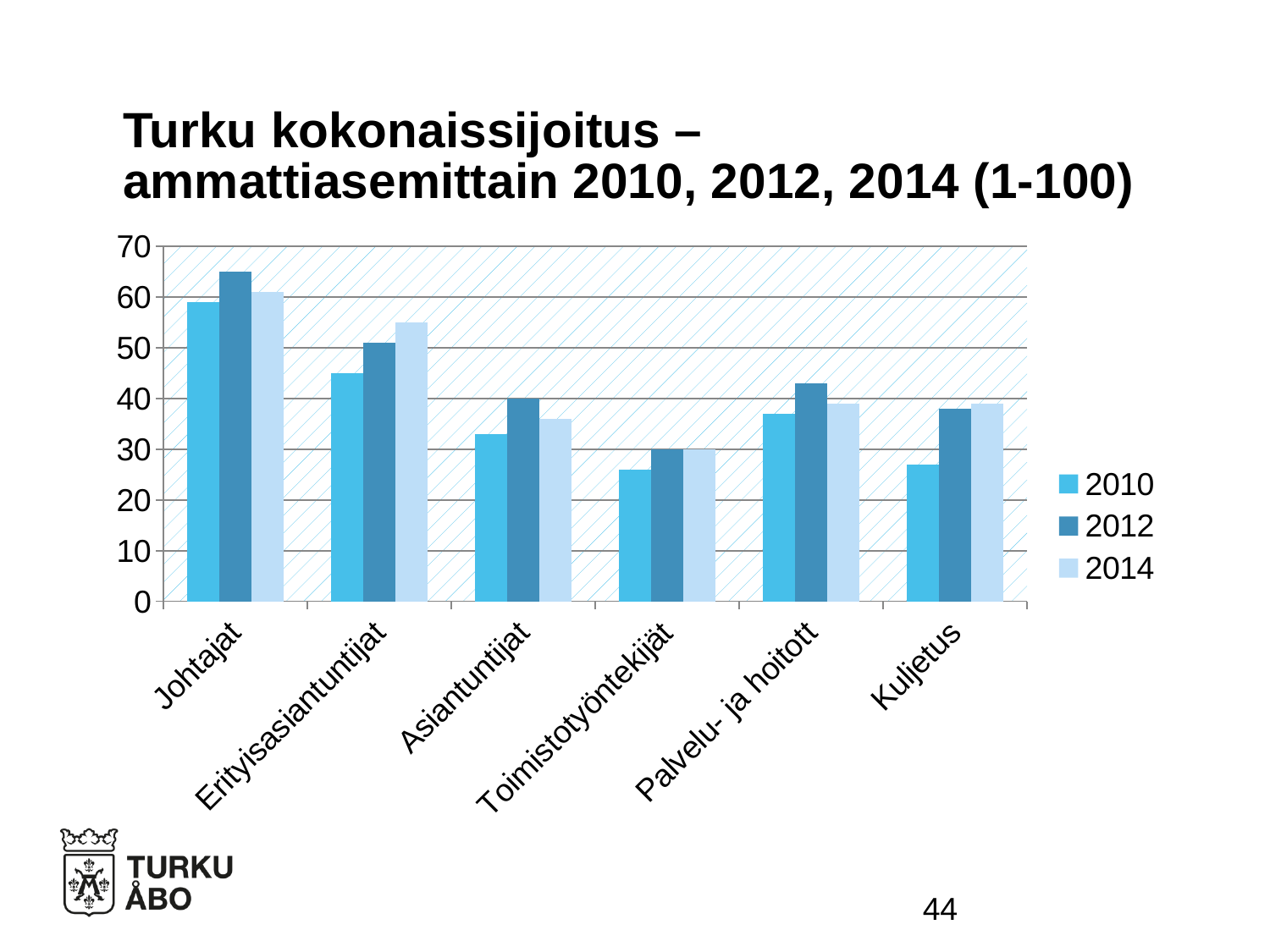
Which years are listed in the chart legend? 2010, 2012, 2014 How many occupational categories are shown on the x axis? 6 For Kuljetus, which is larger: the 2010 value or the 2012 value? 2012 Is the 2010 value for Kuljetus greater or less than 30? less Do the values for Erityisasiantuntijat rise or fall from 2010 to 2014? rise What kind of chart is shown on the slide? bar chart How many series does the legend list? 3 Which category has the lowest value for 2012? Toimistotyöntekijät Is the 2014 value for Erityisasiantuntijat greater or less than 50? greater Is the 2010 value for Toimistotyöntekijät greater or less than 30? less Which category has the highest value for 2012? Johtajat